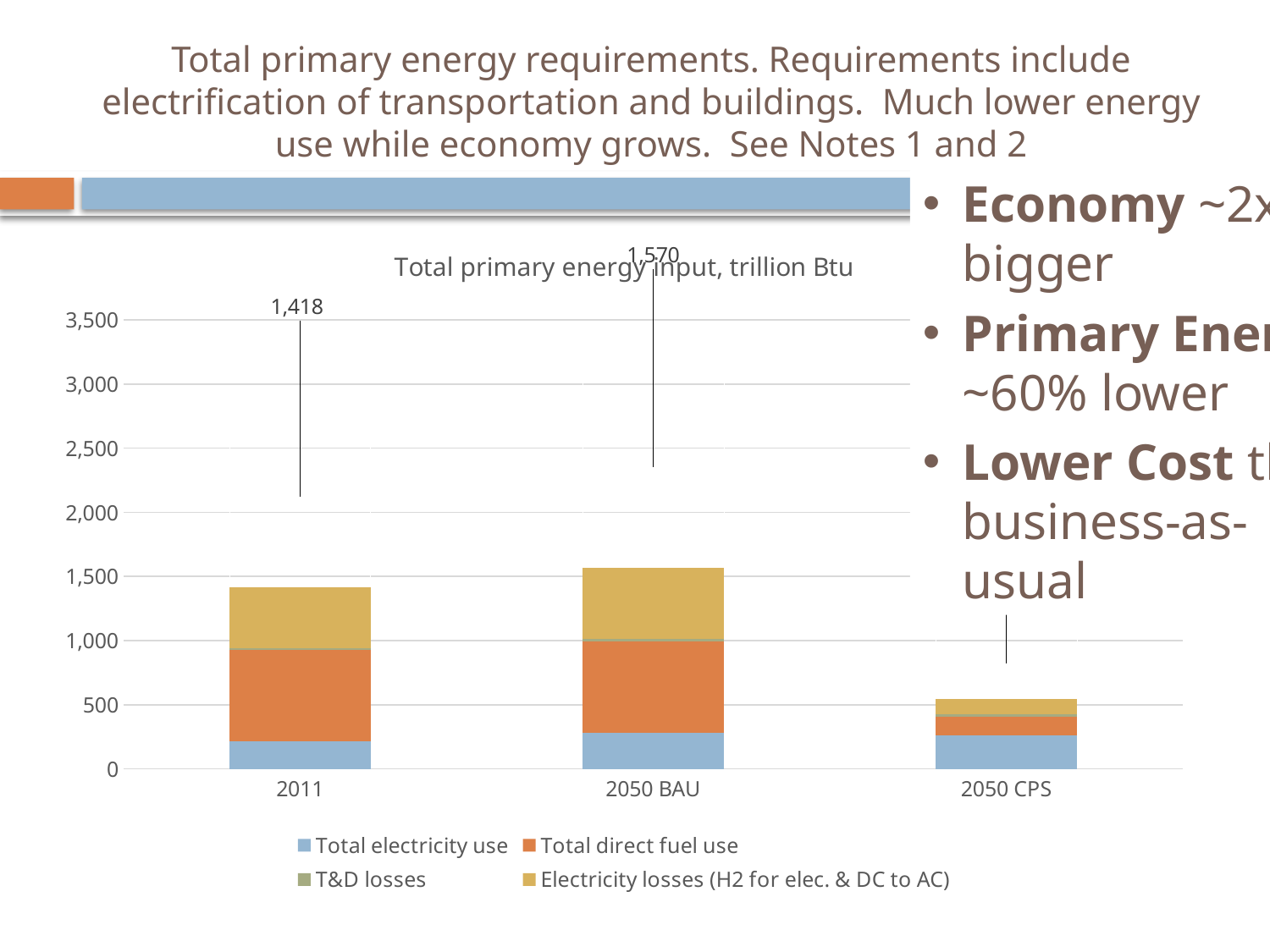
Is the total for 2050 CPS greater or less than 1,000? less What is the total primary energy input for 2011? 1,418 What is the title of the chart? Total primary energy input, trillion Btu Which category has the highest total primary energy input? 2050 BAU How many categories are shown on the x axis? 3 Which is larger, the total for 2011 or the total for 2050 BAU? 2050 BAU Which category has the lowest total primary energy input? 2050 CPS What is the difference between the total for 2050 BAU and the total for 2011? 152 How many series does the legend list? 4 Is the Total electricity use value for 2050 BAU greater or less than 500? less What kind of chart is shown on the slide? Stacked bar chart What is the total primary energy input for 2050 BAU? 1,570